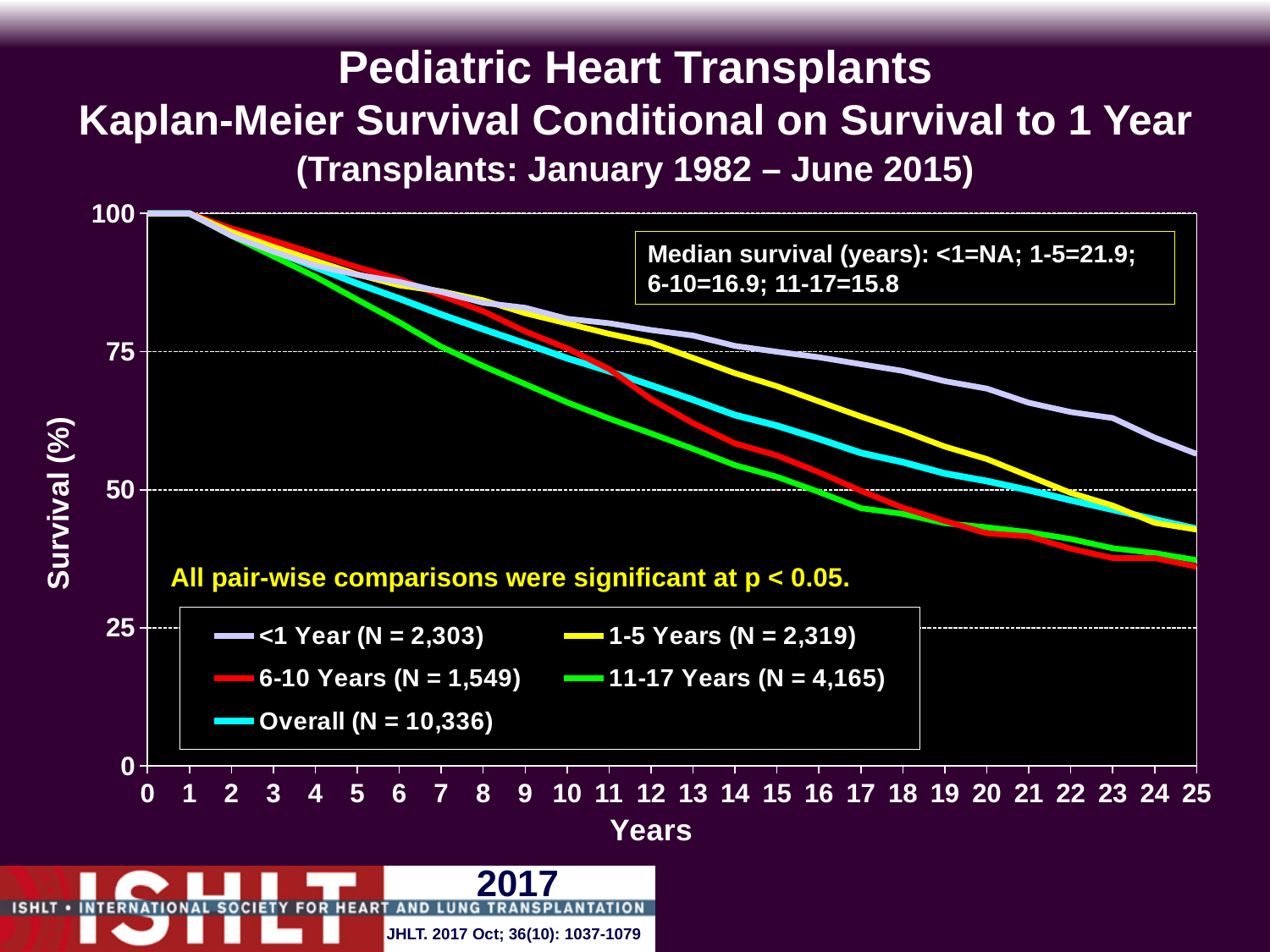
Which series has the lowest survival at year 10? 11-17 Years What is the median survival in years for the 11-17 Years group, as stated in the text box? 15.8 What kind of chart is shown on the slide? line chart Which series has the highest survival at year 25? <1 Year Do the survival curves rise or fall as years increase along the x axis? fall What colour is the line for the Overall series? cyan What is the median survival in years for the 1-5 Years group, as stated in the text box? 21.9 What is the N for the Overall series in the legend? 10,336 At year 20, which is larger: the survival for <1 Year or for 6-10 Years? <1 Year Is the survival for the 11-17 Years series at year 25 greater or less than 50? less What is the difference in median survival (years) between the 1-5 Years group and the 11-17 Years group? 6.1 How many series does the legend list? 5